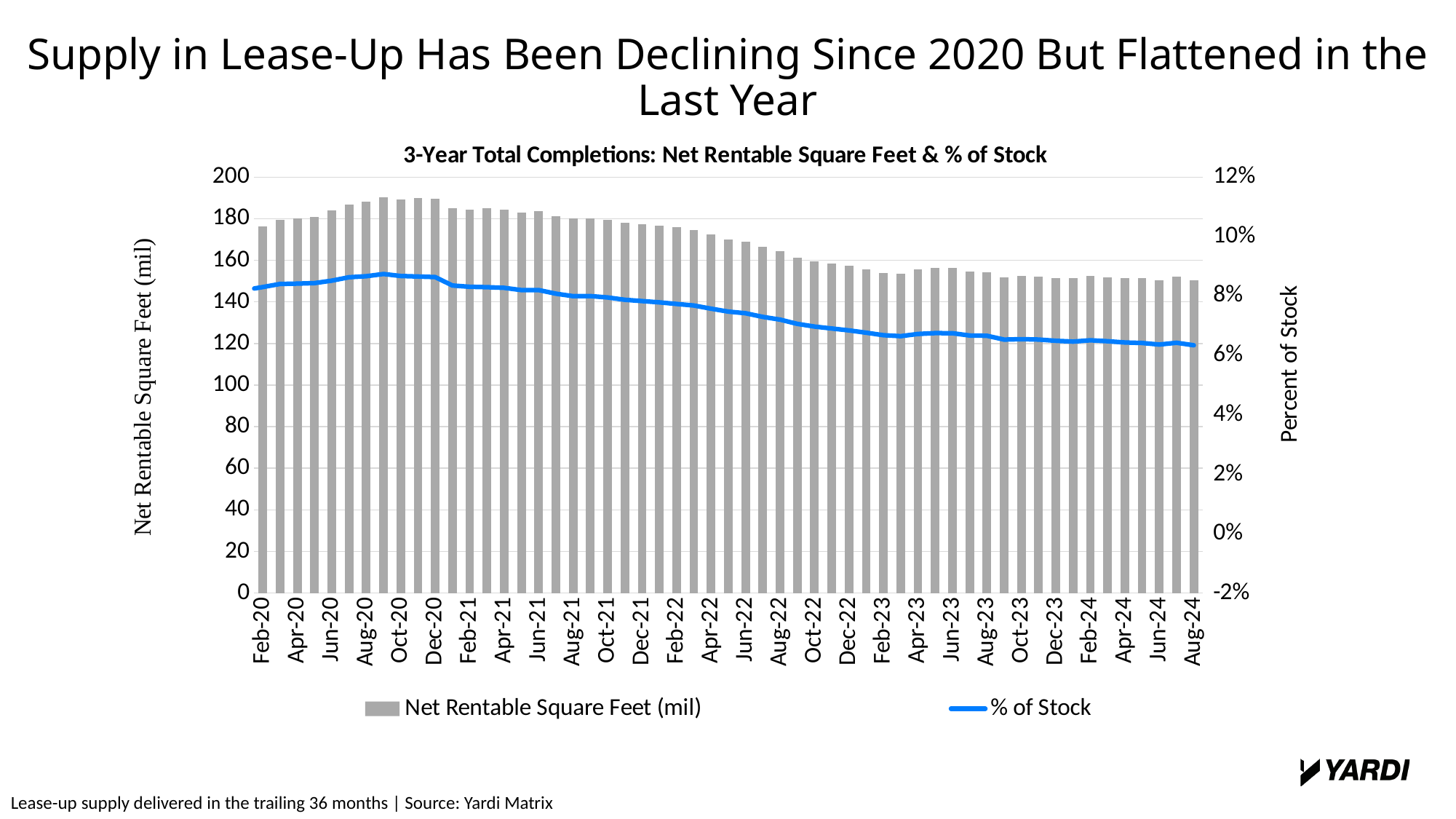
Which has the larger % of Stock value, Oct-20 or Feb-23? Oct-20 What is the title of the chart? 3-Year Total Completions: Net Rentable Square Feet & % of Stock Is the % of Stock value for Aug-24 greater or less than 8%? less What is the label of the right-hand vertical axis? Percent of Stock What kind of chart is shown on the slide? A combination bar and line chart Is the Net Rentable Square Feet (mil) value for Oct-20 greater or less than 180? greater Does the % of Stock line generally rise or fall from Oct-20 to Aug-24? Fall Is the Net Rentable Square Feet (mil) value for Feb-20 greater or less than 160? greater How many series does the legend list? 2 Which has the larger Net Rentable Square Feet (mil) value, Feb-20 or Aug-24? Feb-20